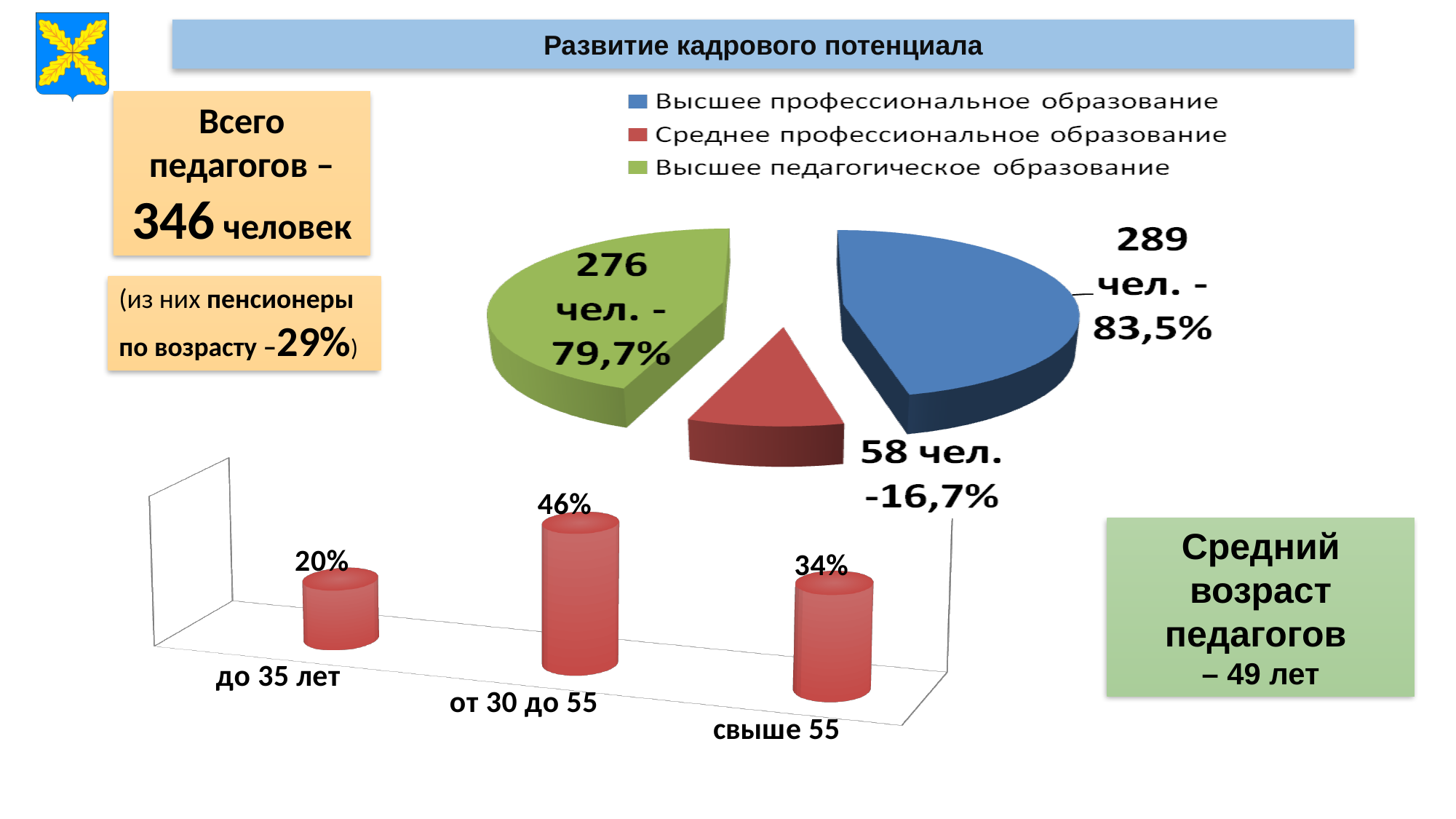
In the pie chart, what percentage is shown for Среднее профессиональное образование? 16,7% In the bar chart at the bottom, what is the value for the age group от 30 до 55? 46% What type of chart is shown at the bottom of the slide? Bar chart In the pie chart, how many people have higher professional education (Высшее профессиональное образование)? 289 чел. In the pie chart, what is the difference in people between Высшее профессиональное образование and Высшее педагогическое образование? 13 In the bar chart at the bottom, which age group has the lowest value? до 35 лет In the pie chart, which category has the smallest slice? Среднее профессиональное образование In the pie chart, what percentage is shown for Высшее педагогическое образование? 79,7% In the bar chart at the bottom, how many age categories are shown? 3 In the bar chart at the bottom, what is the difference between the values for свыше 55 and до 35 лет? 14% In the pie chart, which category has the largest slice? Высшее профессиональное образование How many entries does the pie chart legend list? 3